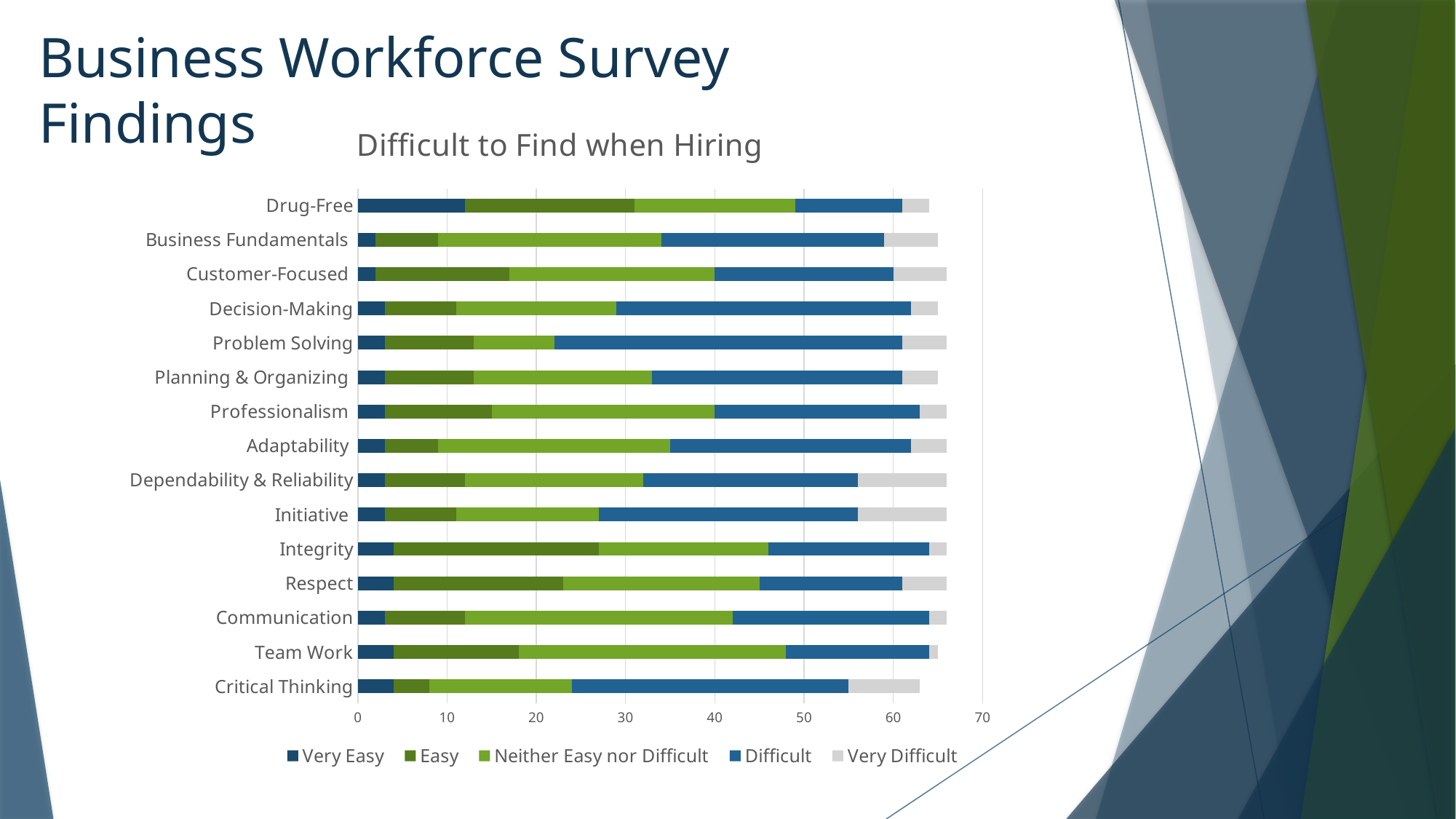
What kind of chart is shown on the slide? Stacked bar chart Is the Difficult value for Problem Solving greater or less than 30? greater What is the title of the chart? Difficult to Find when Hiring Which category has the largest Very Easy segment? Drug-Free Is the Very Easy value for Critical Thinking greater or less than 10? less Is the Very Easy value for Drug-Free greater or less than 10? greater Which has the larger Neither Easy nor Difficult segment, Business Fundamentals or Critical Thinking? Business Fundamentals Which series is shown in grey in the legend? Very Difficult Which has the larger Easy segment, Drug-Free or Business Fundamentals? Drug-Free Which has the larger Difficult segment, Critical Thinking or Drug-Free? Critical Thinking How many categories (skills) are plotted on the chart? 15 How many series does the legend list? 5